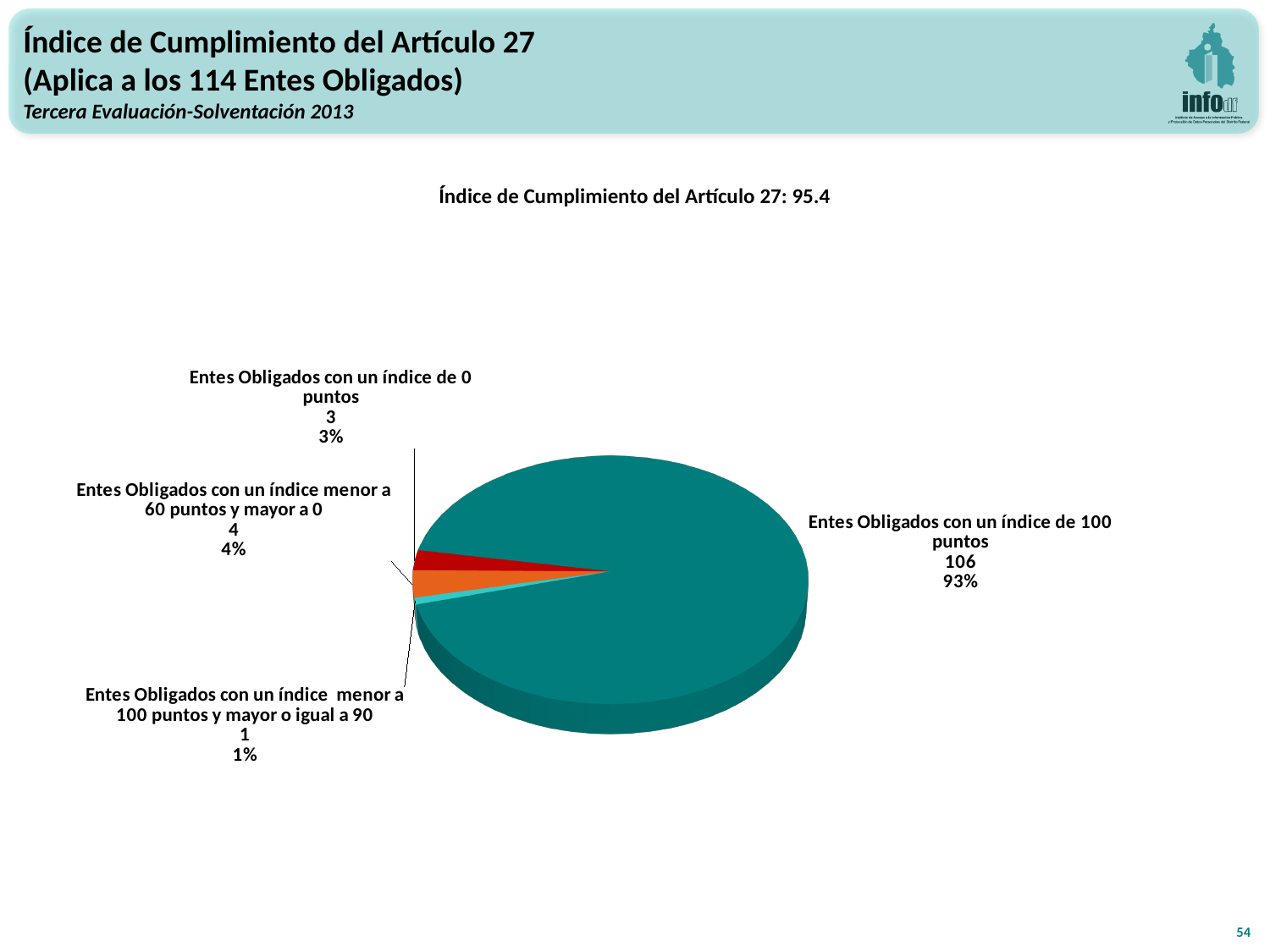
What kind of chart is shown on the slide? Pie chart What is the Índice de Cumplimiento del Artículo 27 value stated above the chart? 95.4 Which is larger: the count for 'índice menor a 60 puntos y mayor a 0' or the count for 'índice de 0 puntos'? índice menor a 60 puntos y mayor a 0 How many Entes Obligados have an índice menor a 100 puntos y mayor o igual a 90? 1 What share of the pie is 'Entes Obligados con un índice de 100 puntos'? 93% Which category has the smallest slice of the pie? Entes Obligados con un índice menor a 100 puntos y mayor o igual a 90 How many Entes Obligados have an índice de 100 puntos? 106 How many slices does the pie chart have? 4 What is the difference in count between 'Entes Obligados con un índice de 100 puntos' and 'Entes Obligados con un índice de 0 puntos'? 103 What percentage is shown for 'Entes Obligados con un índice menor a 60 puntos y mayor a 0'? 4% How many Entes Obligados have an índice de 0 puntos? 3 Which category has the largest slice of the pie? Entes Obligados con un índice de 100 puntos